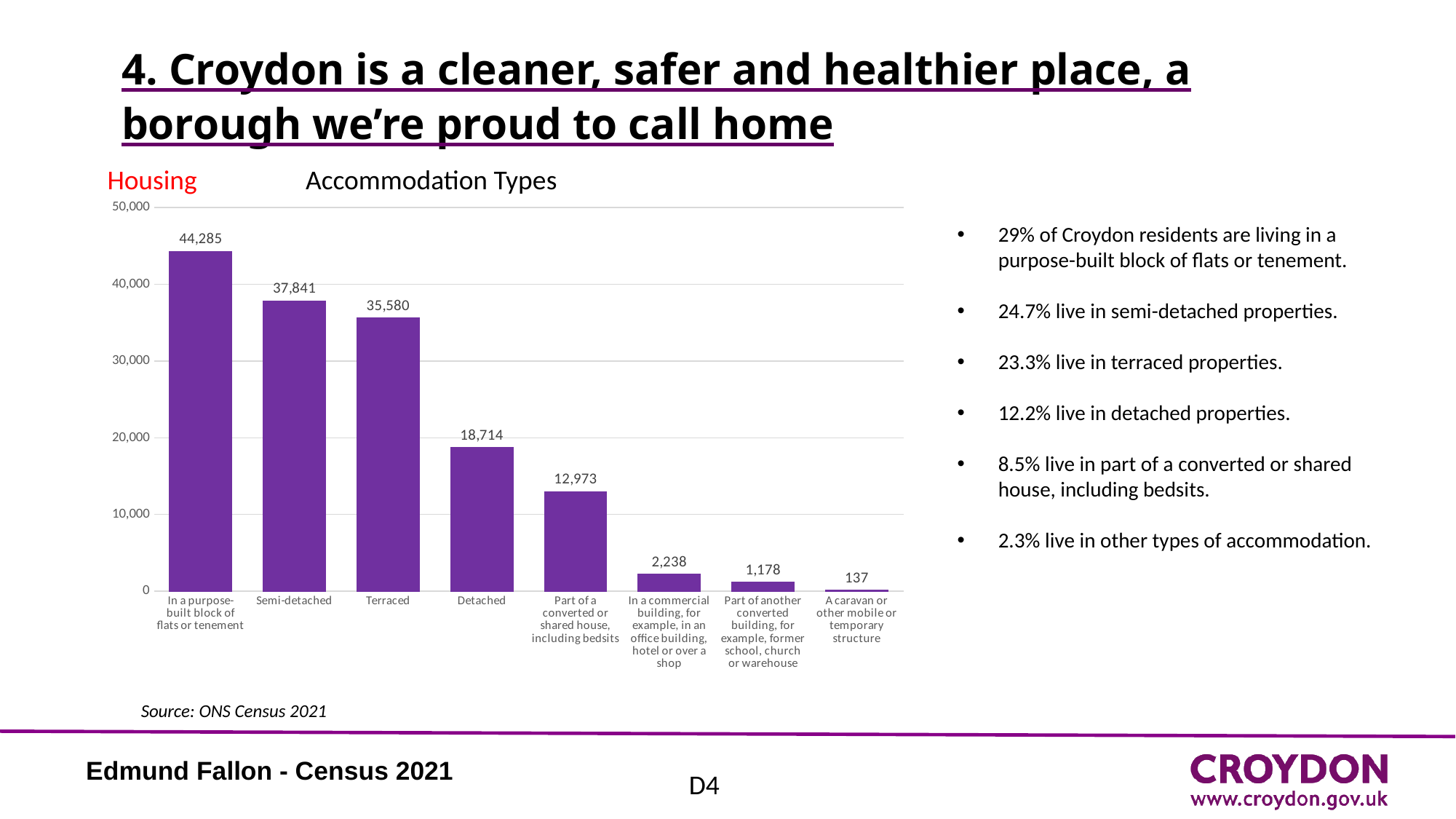
Which is larger: the value for Detached or the value for 'Part of a converted or shared house, including bedsits'? Detached What is the difference between the values for Semi-detached and Terraced? 2,261 What is the value for Semi-detached in the Accommodation Types chart? 37,841 What kind of chart is used to show Accommodation Types? bar chart Which accommodation type has the highest value? In a purpose-built block of flats or tenement What is the title of the chart? Accommodation Types Do the values rise or fall from left to right across the categories? fall What is the value for 'A caravan or other mobile or temporary structure'? 137 How many accommodation types are shown in the chart? 8 Is the value for Terraced greater or less than 40,000? less What is the value for Detached in the Accommodation Types chart? 18,714 Which accommodation type has the lowest value? A caravan or other mobile or temporary structure